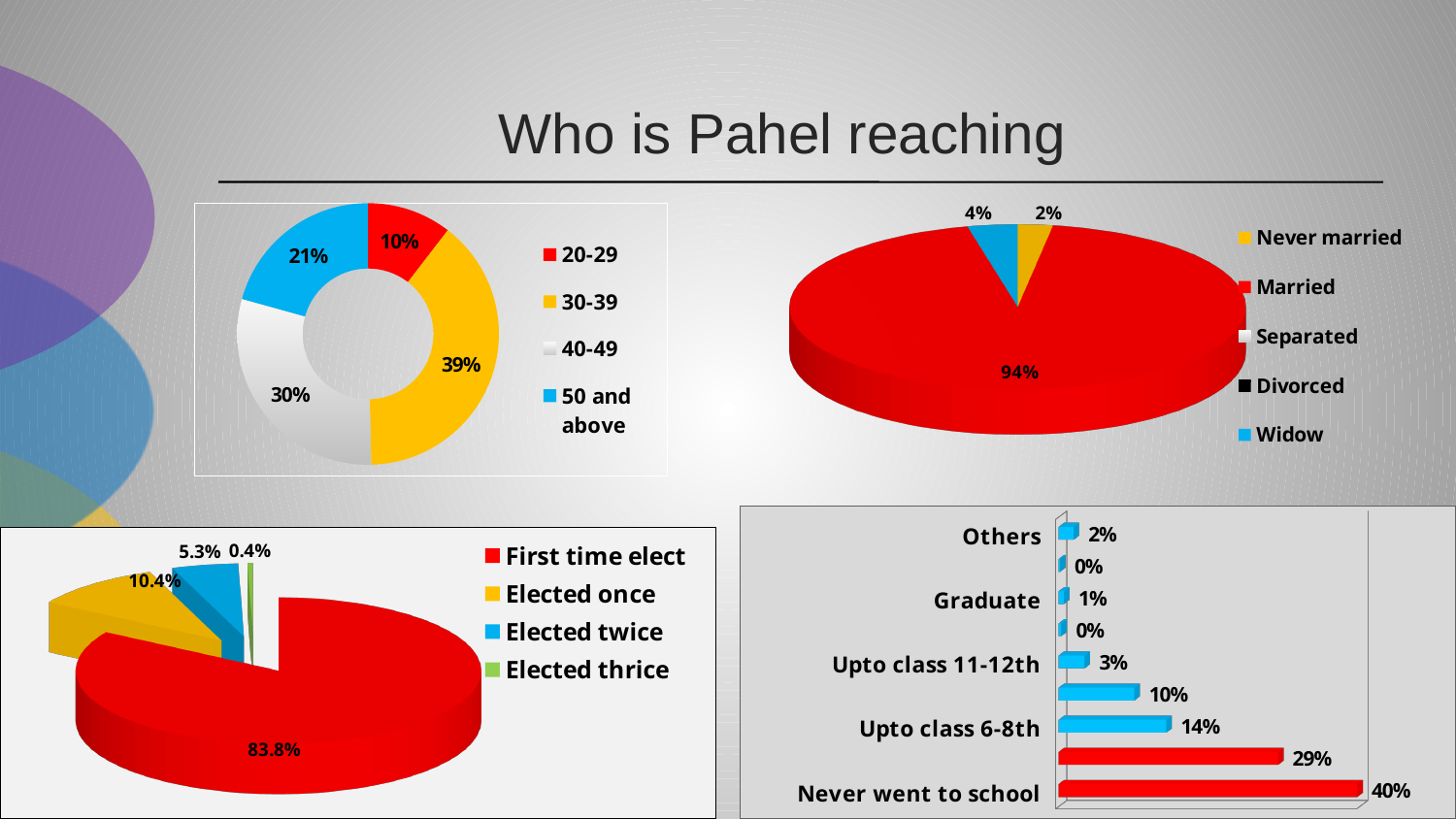
In the bottom-left election pie chart, what is the difference between Elected twice and Elected thrice? 4.9% In the top-left age chart, what is the difference between the 40-49 share and the 50 and above share? 9% In the bottom-right education bar chart, what is the value for Never went to school? 40% In the bottom-right education bar chart, which is larger, Upto class 6-8th or Upto class 11-12th? Upto class 6-8th In the top-left age chart, which age group has the smallest share? 20-29 How many bars are plotted in the bottom-right education bar chart? 9 In the bottom-left election pie chart, what percentage is shown for Elected once? 10.4% How many entries does the legend of the top-right marital status pie chart list? 5 In the bottom-left election pie chart, which category has the largest share? First time elect In the top-right marital status pie chart, what percentage is shown for Married? 94% What kind of chart is the top-left age chart? Donut chart In the top-left age chart, what percentage is shown for the 30-39 group? 39%